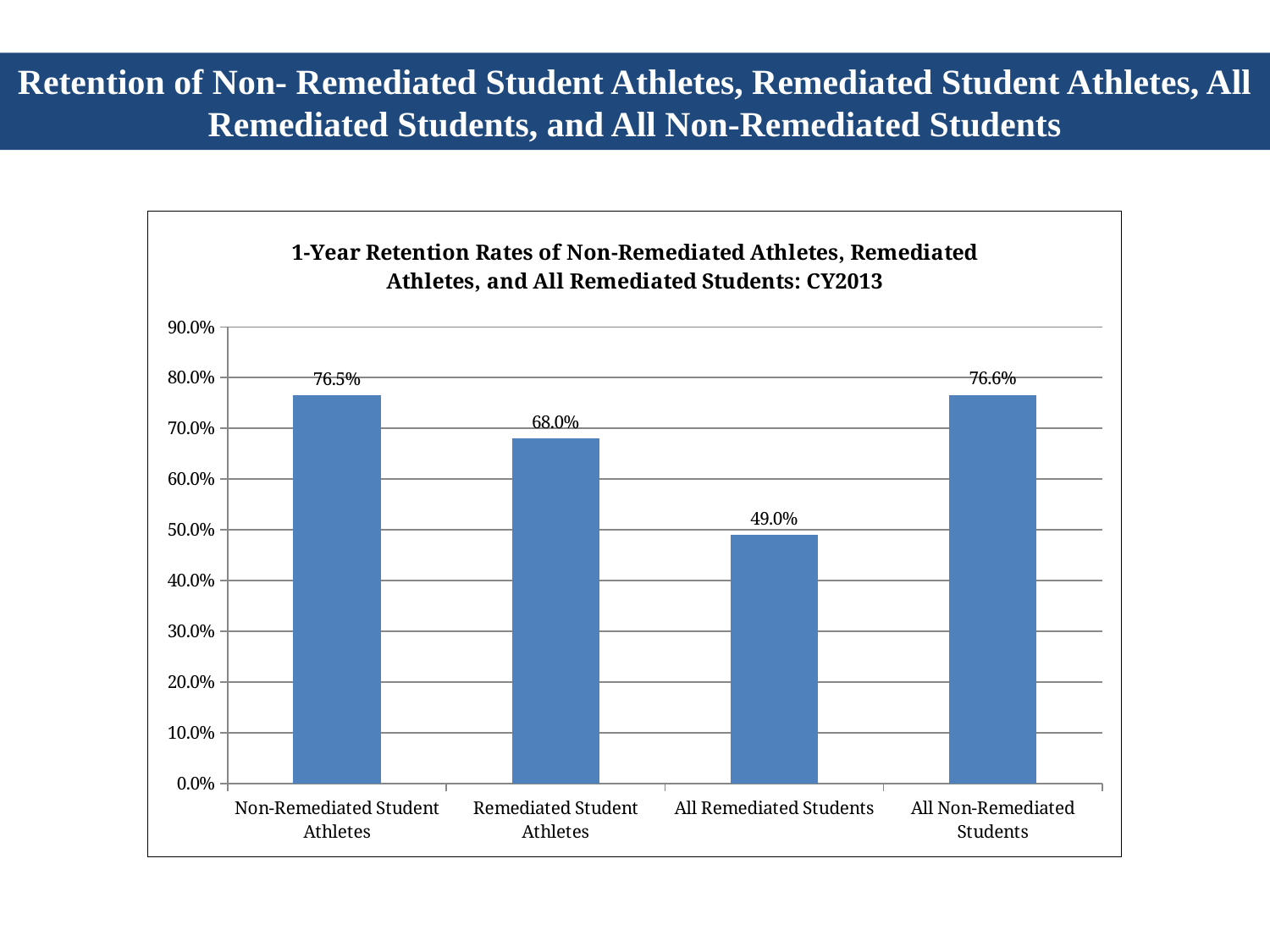
What is the 1-year retention rate for All Non-Remediated Students? 76.6% What is the 1-year retention rate for All Remediated Students? 49.0% Which category has the lowest 1-year retention rate? All Remediated Students What is the difference in retention rate between Remediated Student Athletes and All Remediated Students? 19.0% Which has a higher retention rate, Remediated Student Athletes or All Remediated Students? Remediated Student Athletes What is the difference in retention rate between Non-Remediated Student Athletes and Remediated Student Athletes? 8.5% Is the retention rate for All Remediated Students greater or less than 50.0%? less What is the 1-year retention rate for Non-Remediated Student Athletes? 76.5% How many categories are shown on the chart? 4 What kind of chart is shown on the slide? Bar chart What calendar year does the chart title say the retention rates are for? CY2013 What is the 1-year retention rate for Remediated Student Athletes? 68.0%